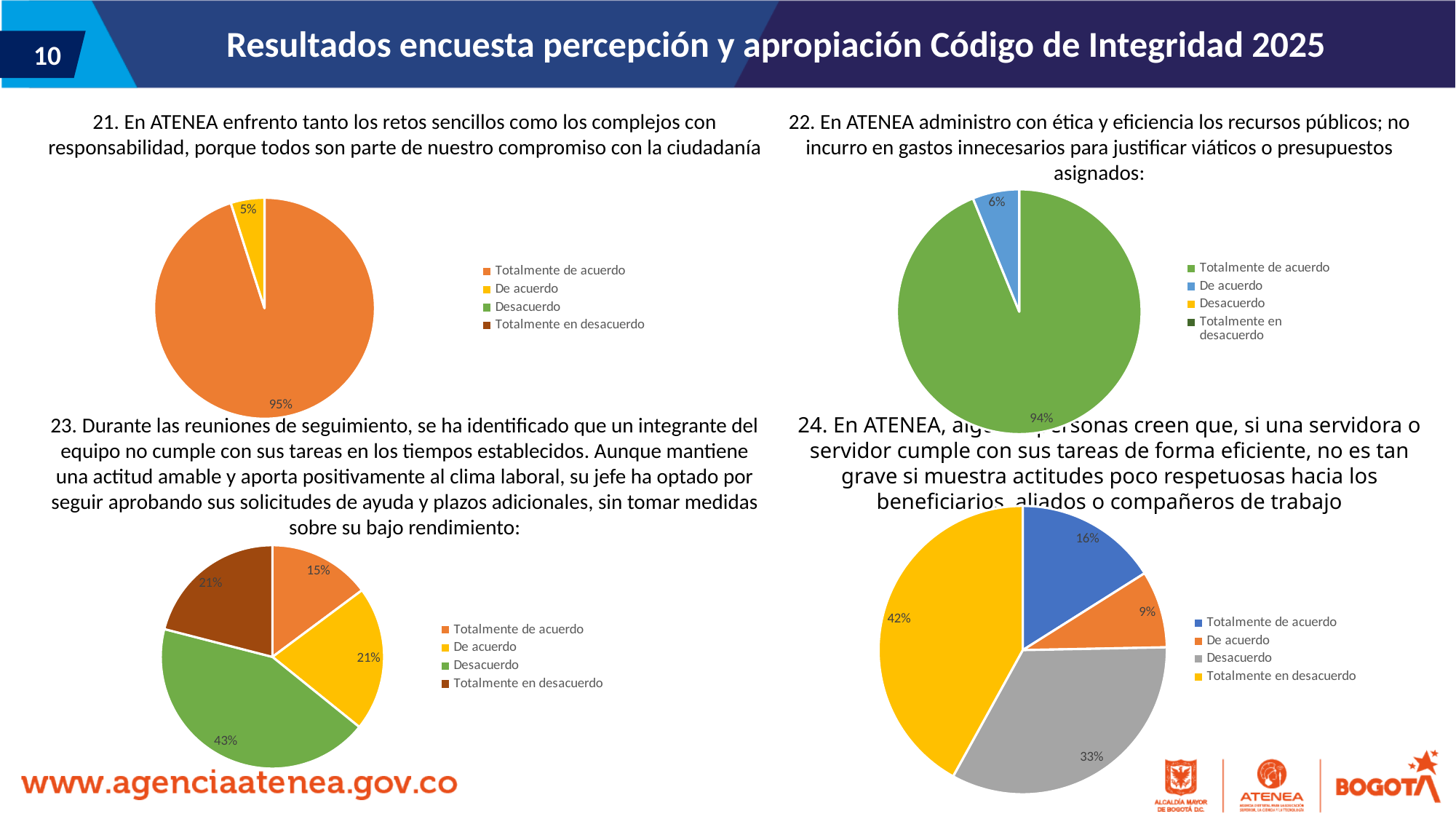
In the chart for question 24 (bottom-right), which is larger: the 'Desacuerdo' share or the 'Totalmente de acuerdo' share? Desacuerdo In the chart for question 23 (bottom-left), what is the difference between the 'Desacuerdo' share and the 'Totalmente de acuerdo' share? 28% In the chart for question 22 (top-right), what share of respondents answered 'De acuerdo'? 6% How many entries does the legend of the chart for question 24 (bottom-right) list? 4 In the chart for question 24 (bottom-right), what is the difference between the 'Totalmente en desacuerdo' share and the 'De acuerdo' share? 33% In the chart for question 23 (bottom-left), which response category has the smallest slice? Totalmente de acuerdo What type of chart is used for question 23 (bottom-left)? Pie chart In the chart for question 24 (bottom-right), what share of respondents answered 'Totalmente en desacuerdo'? 42% In the chart for question 23 (bottom-left), what share of respondents answered 'Desacuerdo'? 43% In the chart for question 21 (top-left), what share of respondents answered 'Totalmente de acuerdo'? 95% In the chart for question 21 (top-left), what share of respondents answered 'De acuerdo'? 5% In the chart for question 22 (top-right), which response category has the largest slice? Totalmente de acuerdo